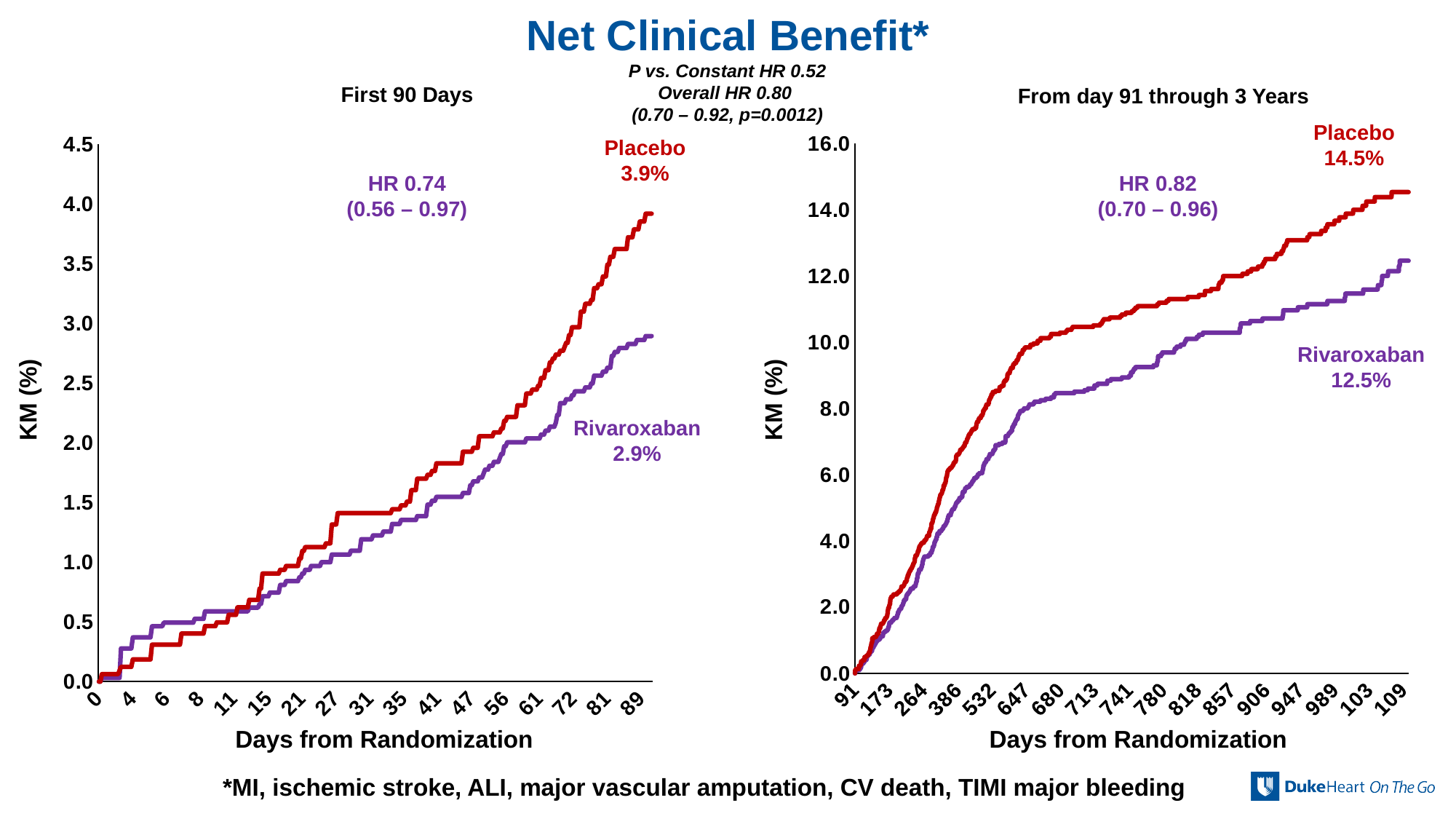
In the 'First 90 Days' chart, what is the difference between the labelled Placebo and Rivaroxaban values? 1.0% In the 'First 90 Days' chart, what is the final KM (%) value labelled for Rivaroxaban? 2.9% In the 'From day 91 through 3 Years' chart, what is the final KM (%) value labelled for Rivaroxaban? 12.5% What is the y-axis label on the 'First 90 Days' chart? KM (%) What kind of chart is the 'First 90 Days' chart? Line chart In the 'From day 91 through 3 Years' chart, what is the final KM (%) value labelled for Placebo? 14.5% How many series (groups) are plotted in the 'From day 91 through 3 Years' chart? 2 In the 'First 90 Days' chart, what is the final KM (%) value labelled for Placebo? 3.9% In the 'First 90 Days' chart, do the curves rise or fall as days from randomization increase? Rise In the 'From day 91 through 3 Years' chart, is the Placebo value at day 647 greater or less than 8.0? greater In the 'From day 91 through 3 Years' chart, which group has the higher final KM (%) value, Placebo or Rivaroxaban? Placebo In the 'From day 91 through 3 Years' chart, what is the difference between the labelled Placebo and Rivaroxaban values? 2.0%